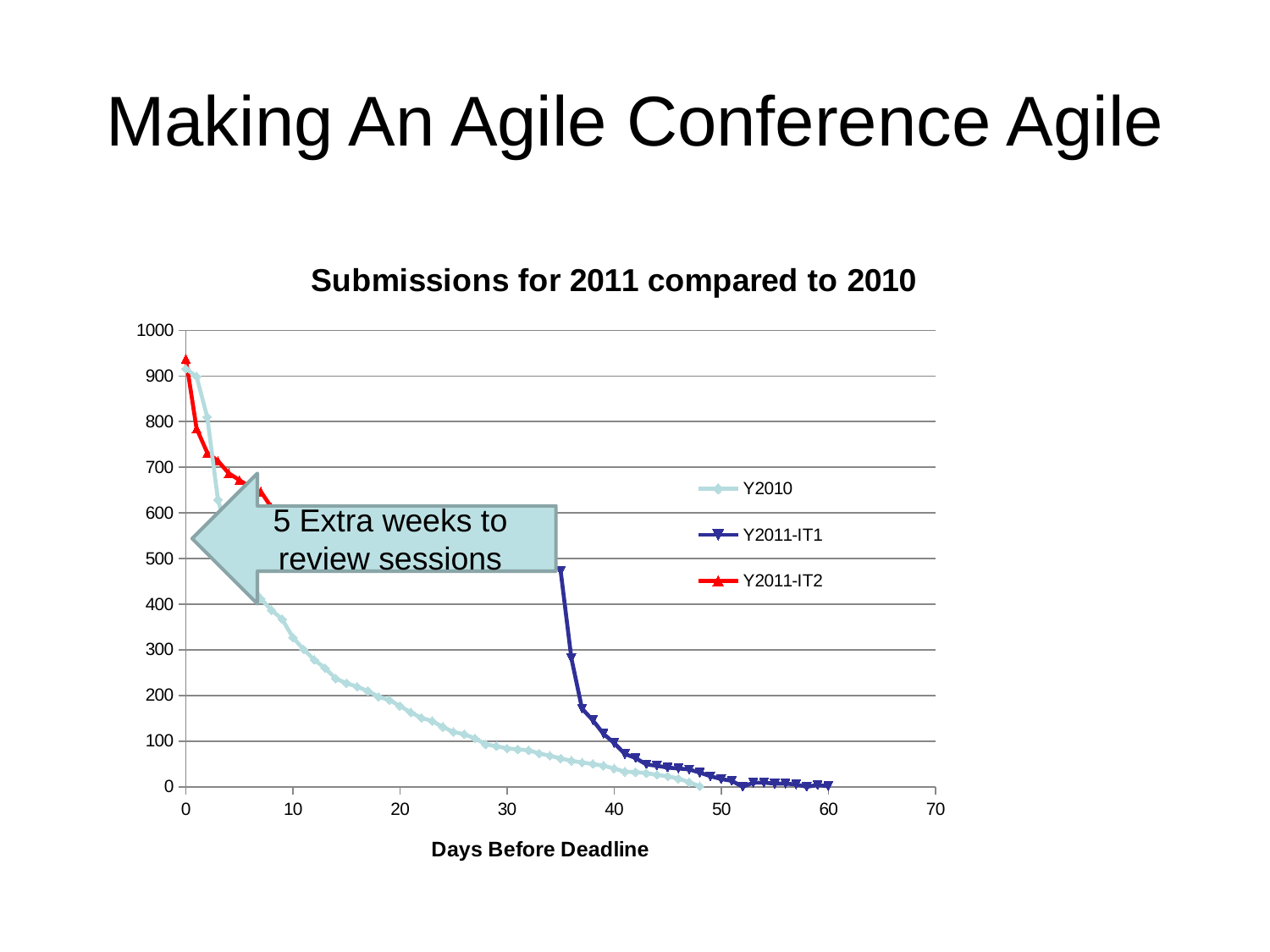
Is the value of Y2010 at 10 days before deadline greater or less than 300? greater Do the values of the Y2010 series rise or fall as Days Before Deadline increases? fall Do the values of the Y2011-IT1 series rise or fall as Days Before Deadline increases? fall Is the value of Y2010 at 20 days before deadline greater or less than 200? less Is the value of Y2011-IT1 at 35 days before deadline greater or less than 500? less What are the series names listed in the chart's legend? Y2010, Y2011-IT1, Y2011-IT2 At 5 days before deadline, which series has the larger value, Y2010 or Y2011-IT2? Y2011-IT2 What is the title of the chart? Submissions for 2011 compared to 2010 What kind of chart is shown on the slide? line chart How many series does the chart's legend list? 3